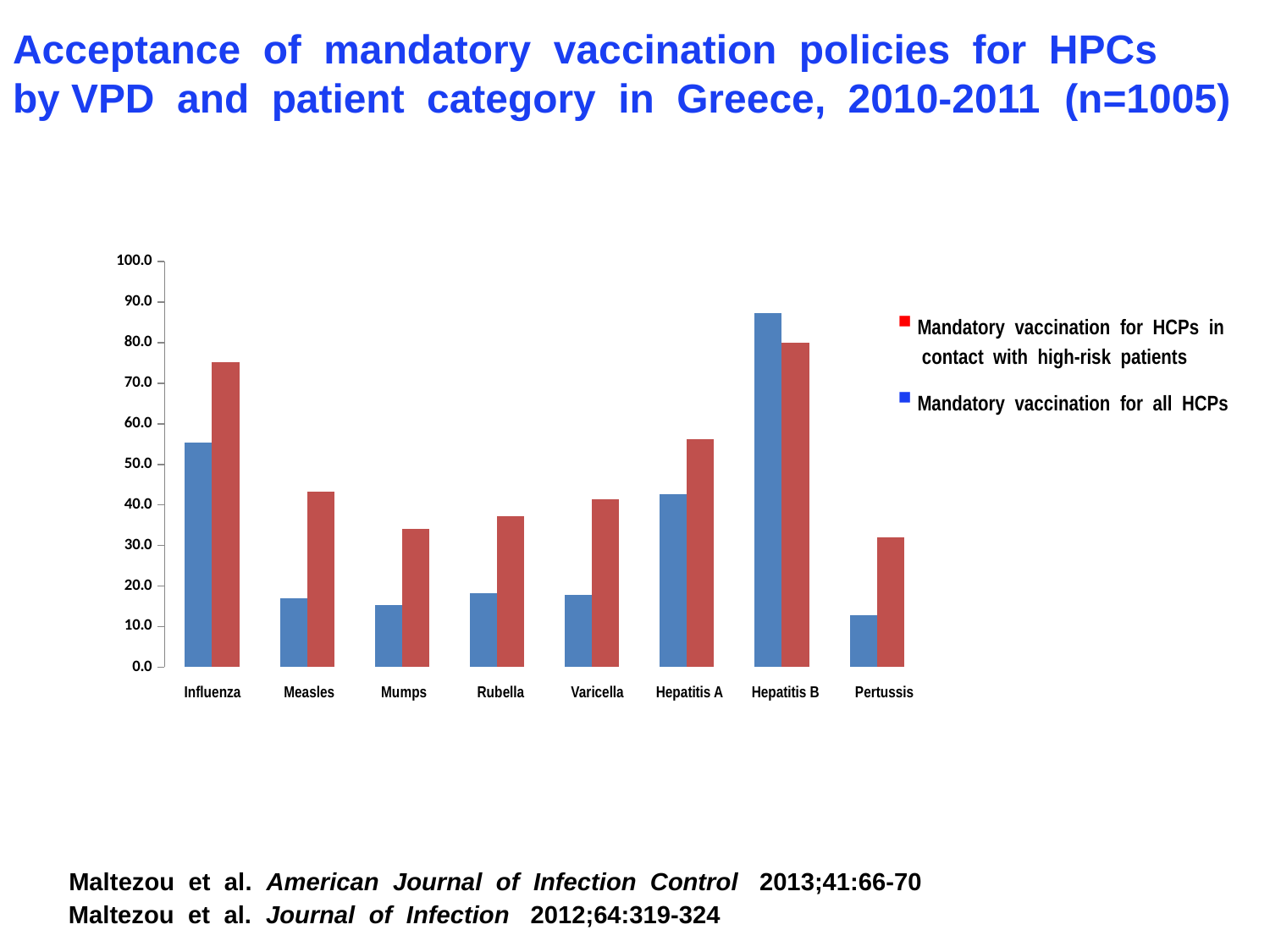
For Influenza, which is larger: 'Mandatory vaccination for all HCPs' or 'Mandatory vaccination for HCPs in contact with high-risk patients'? Mandatory vaccination for HCPs in contact with high-risk patients Which category has the highest value for 'Mandatory vaccination for all HCPs'? Hepatitis B For Hepatitis B, which is larger: 'Mandatory vaccination for all HCPs' or 'Mandatory vaccination for HCPs in contact with high-risk patients'? Mandatory vaccination for all HCPs How many vaccine-preventable disease categories are shown on the x axis? 8 What kind of chart is shown on the slide? bar chart Which category has the highest value for 'Mandatory vaccination for HCPs in contact with high-risk patients'? Hepatitis B How many series does the legend list? 2 Is the value for Mumps in the 'Mandatory vaccination for HCPs in contact with high-risk patients' series greater or less than 40? less Is the value for Hepatitis B in the 'Mandatory vaccination for all HCPs' series greater or less than 80? greater Is the value for Pertussis in the 'Mandatory vaccination for all HCPs' series greater or less than 20? less Which colour represents 'Mandatory vaccination for all HCPs' in the legend? blue